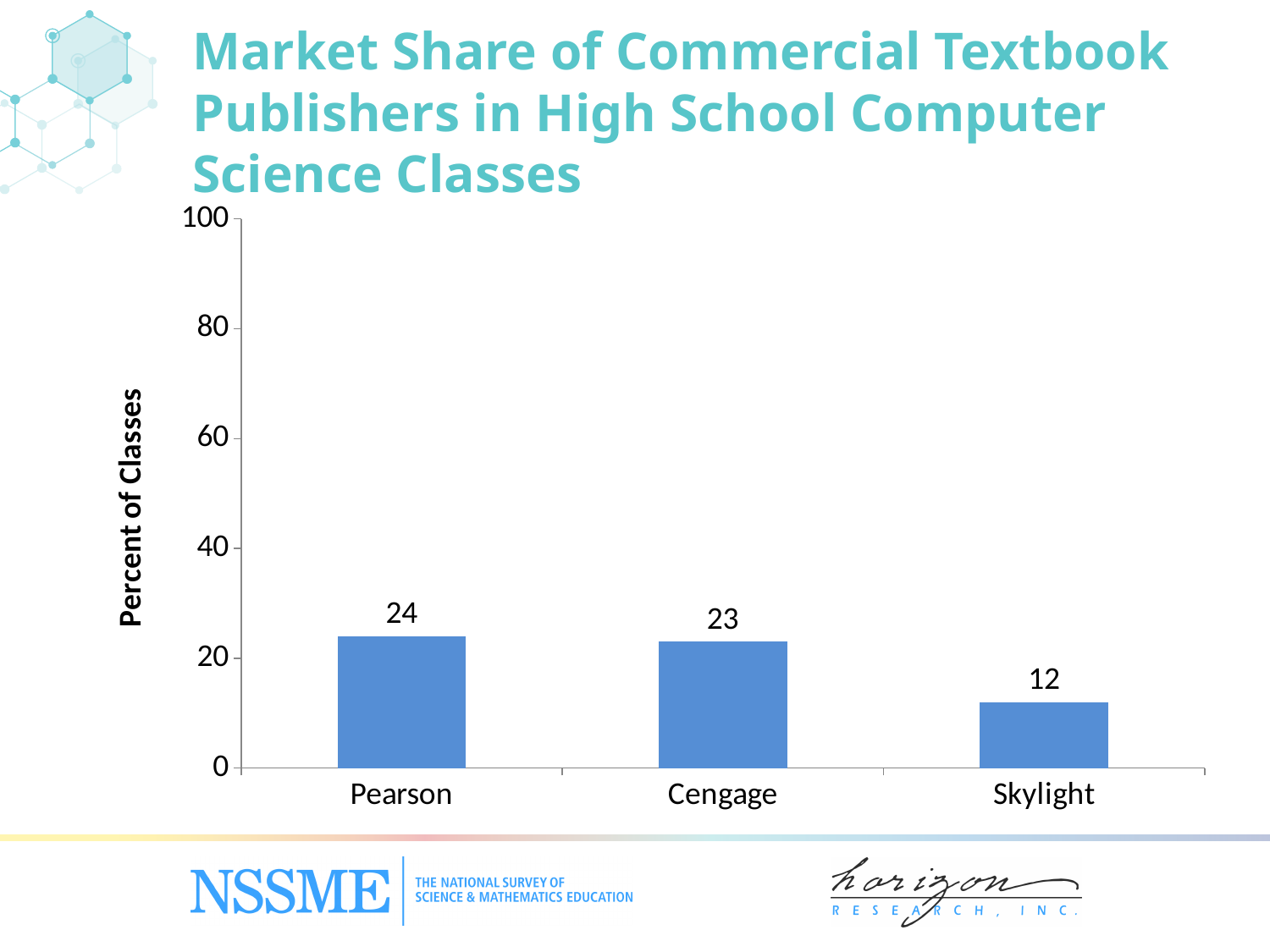
Which is larger, the value for Pearson or the value for Skylight? Pearson What is the value for Cengage? 23 What is the difference between the values for Cengage and Skylight? 11 What is the label of the vertical axis? Percent of Classes Is the value for Pearson greater or less than 20? greater What kind of chart is shown on the slide? bar chart How many publishers are shown in the chart? 3 Is the value for Skylight greater or less than 20? less What is the value for Skylight? 12 What is the difference between the values for Pearson and Skylight? 12 What is the value for Pearson? 24 Which publisher has the lowest percent of classes? Skylight